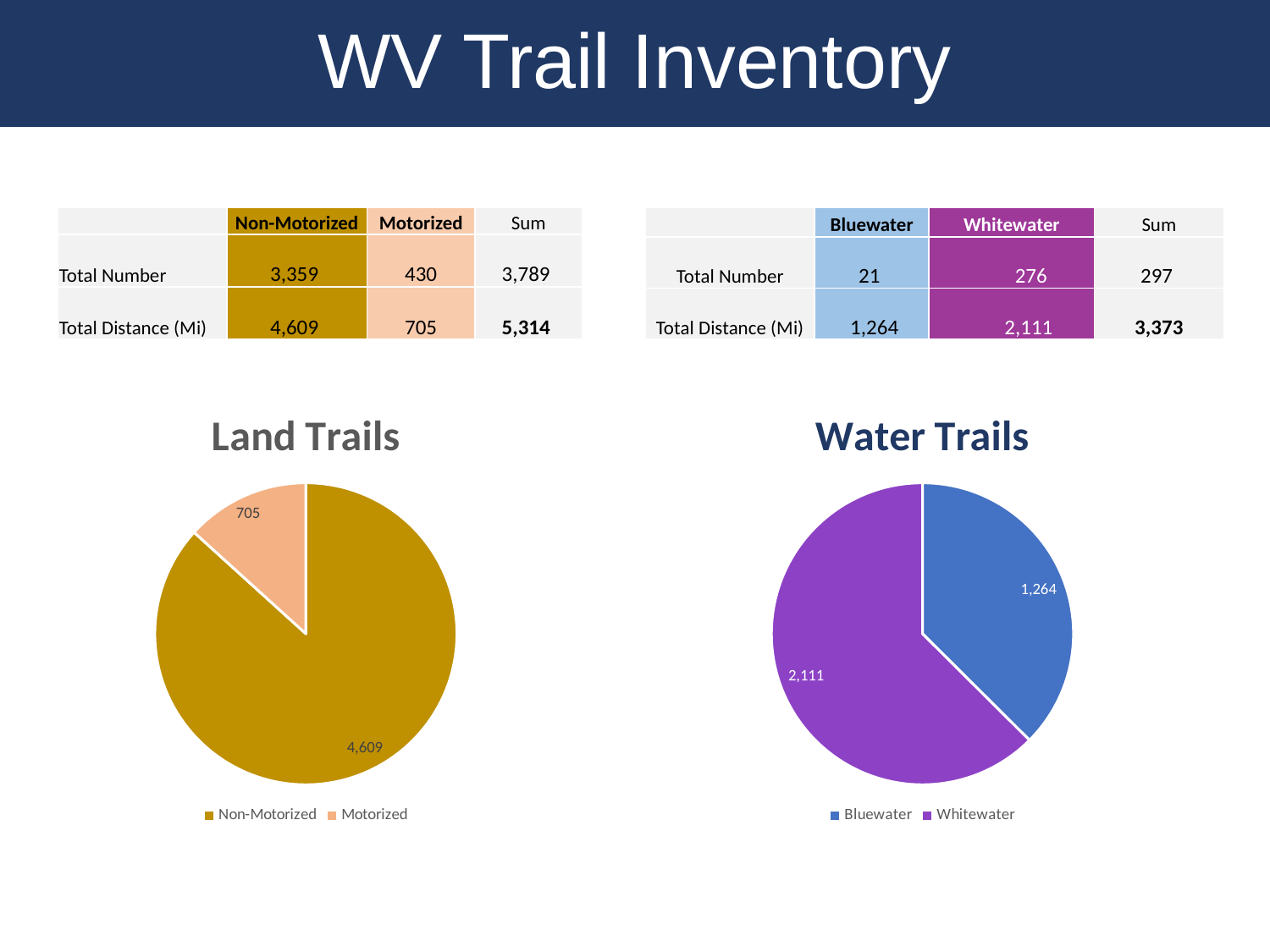
In the Water Trails chart, is the Whitewater slice larger or smaller than the Bluewater slice? larger In the Land Trails chart, what is the value for Motorized? 705 What type of chart is the Land Trails chart? pie chart In the Water Trails chart, what is the difference between the Whitewater and Bluewater values? 847 What are the legend entries of the Land Trails chart? Non-Motorized, Motorized In the Water Trails chart, what is the value for Whitewater? 2,111 In the Land Trails chart, which category has the largest slice? Non-Motorized In the Water Trails chart, which category has the smallest slice? Bluewater In the Land Trails chart, what is the value for Non-Motorized? 4,609 In the Water Trails chart, what is the value for Bluewater? 1,264 How many slices does the Water Trails pie chart have? 2 In the Land Trails chart, what is the difference between the Non-Motorized and Motorized values? 3,904